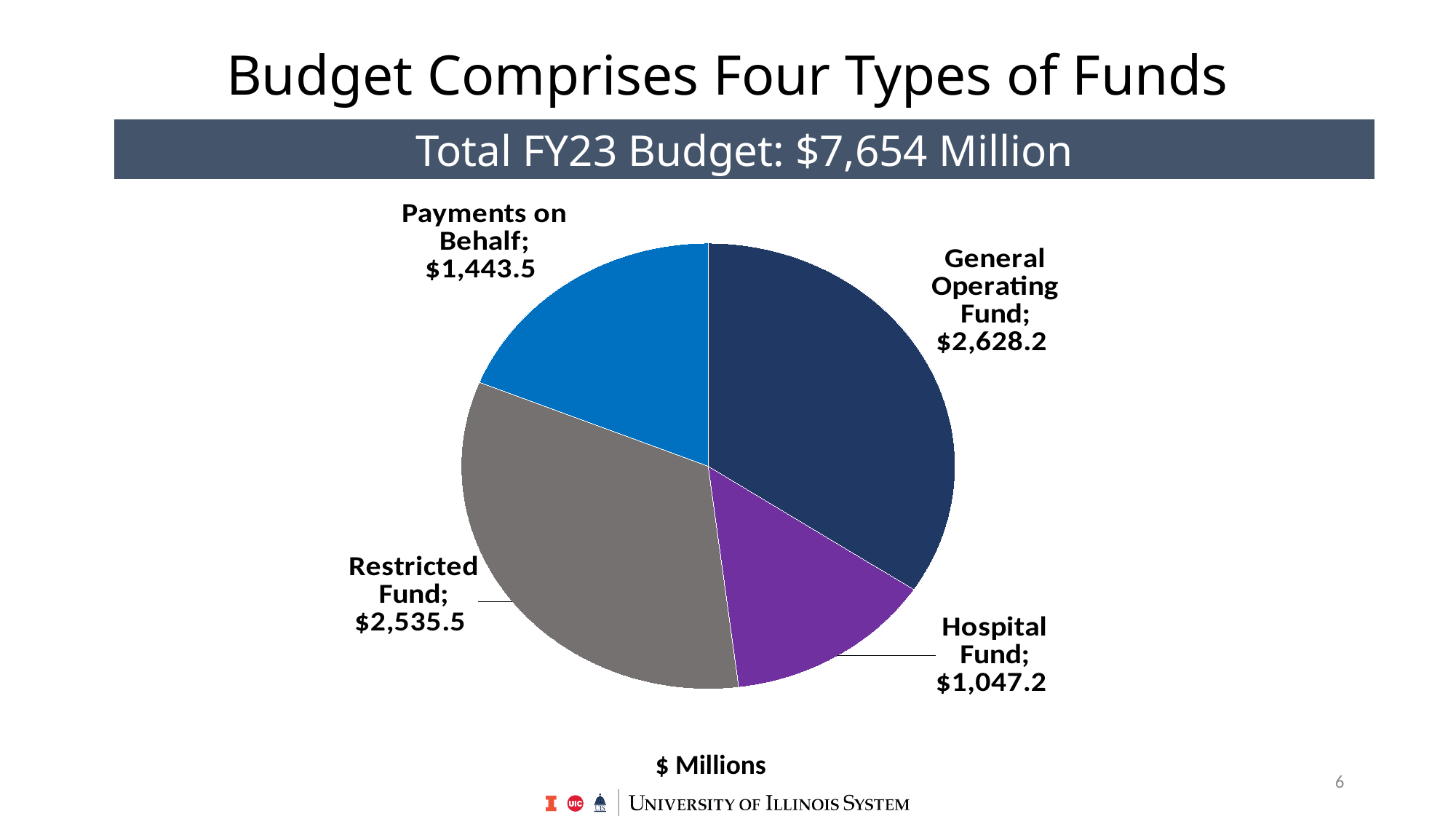
What is the value for the Restricted Fund? $2,535.5 What is the difference between Payments on Behalf and the Hospital Fund values? $396.3 What is the value for the General Operating Fund? $2,628.2 What is the difference between the General Operating Fund and the Restricted Fund values? $92.7 What is the value for Payments on Behalf? $1,443.5 Which is larger, Payments on Behalf or the Hospital Fund? Payments on Behalf Which fund type has the smallest slice of the pie? Hospital Fund How many fund types are shown in the pie chart? 4 Which fund type has the largest slice of the pie? General Operating Fund What kind of chart is shown on the slide? Pie chart What unit is indicated below the pie chart? $ Millions What is the value for the Hospital Fund? $1,047.2